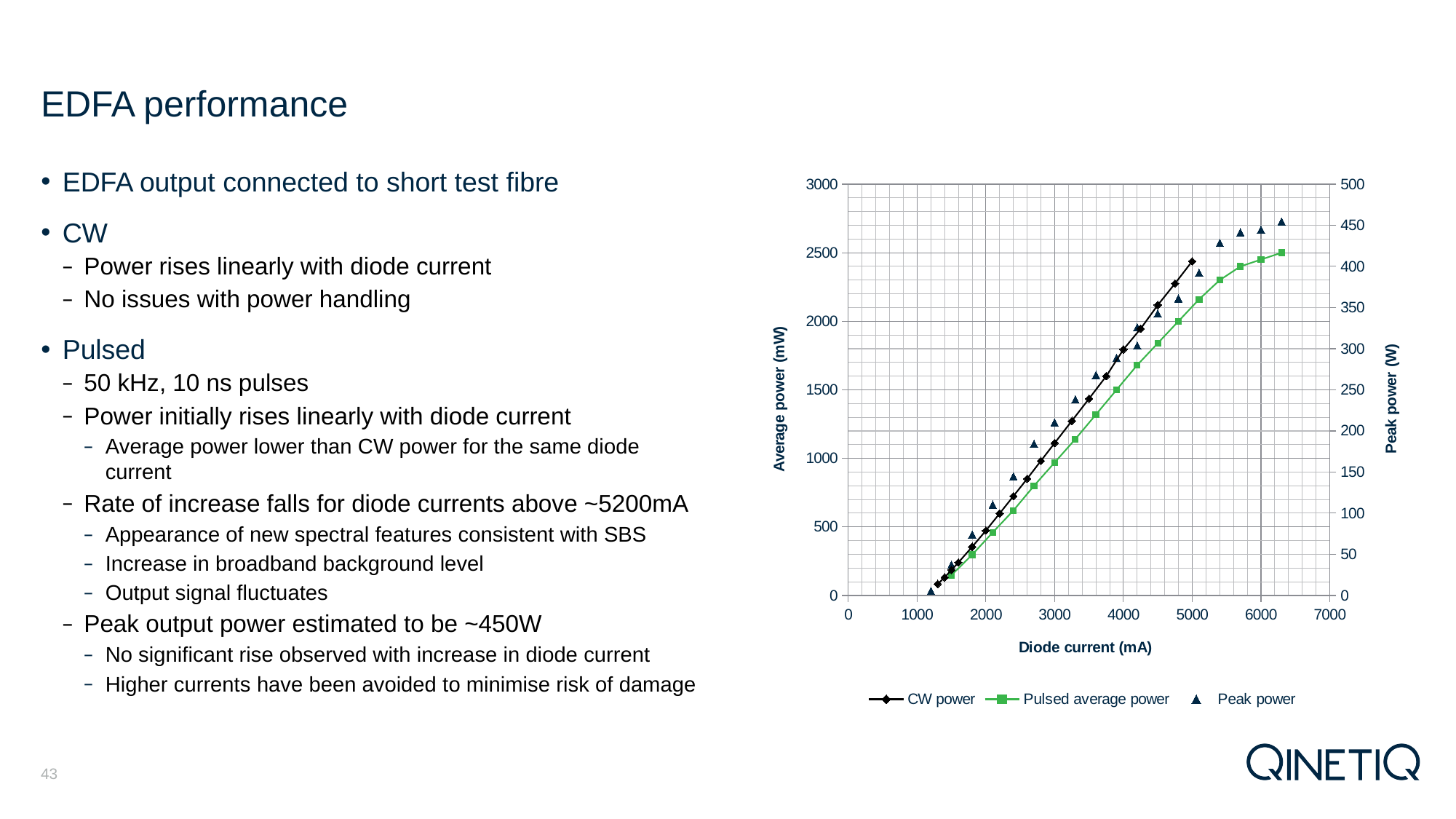
Is the Pulsed average power at a diode current of 2000 mA greater or less than 500 mW? less Does the CW power rise or fall as diode current increases? Rises What is the title of the x axis of the chart? Diode current (mA) What is the highest value shown on the right-hand Peak power (W) axis? 500 Is the Pulsed average power at a diode current of 6000 mA greater or less than 2000 mW? greater At a diode current of 4000 mA, which series has the higher average power, CW power or Pulsed average power? CW power Is the CW power at a diode current of 5000 mA greater or less than 2000 mW? greater What kind of chart is shown on the slide? Line chart Does the Pulsed average power rise or fall as diode current increases? Rises Which series in the chart is plotted with triangle markers? Peak power How many series does the chart legend list? 3 What is the highest value shown on the left-hand Average power (mW) axis? 3000